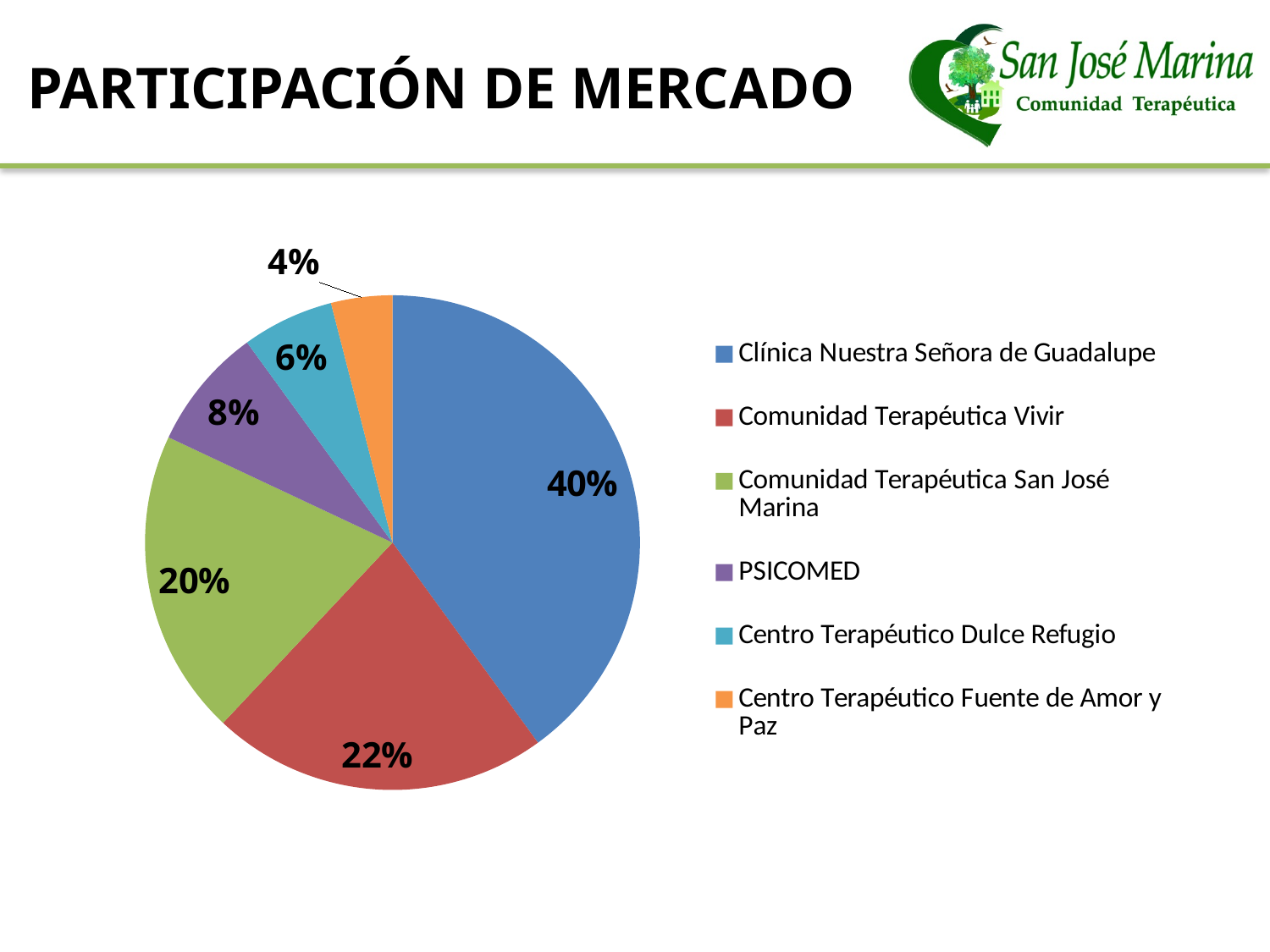
What share of the market does Clínica Nuestra Señora de Guadalupe hold? 40% What is the difference in market share between Clínica Nuestra Señora de Guadalupe and Comunidad Terapéutica Vivir? 18% What kind of chart is shown on the slide? pie chart What colour is the slice for Comunidad Terapéutica San José Marina? green What share of the market does Comunidad Terapéutica Vivir hold? 22% What share of the market does PSICOMED hold? 8% Which organisation has the smallest market share? Centro Terapéutico Fuente de Amor y Paz How many organisations are shown in the pie chart? 6 Which organisation has the largest market share? Clínica Nuestra Señora de Guadalupe What share of the market does Centro Terapéutico Fuente de Amor y Paz hold? 4% Which has a larger market share, PSICOMED or Centro Terapéutico Dulce Refugio? PSICOMED What share of the market does Comunidad Terapéutica San José Marina hold? 20%